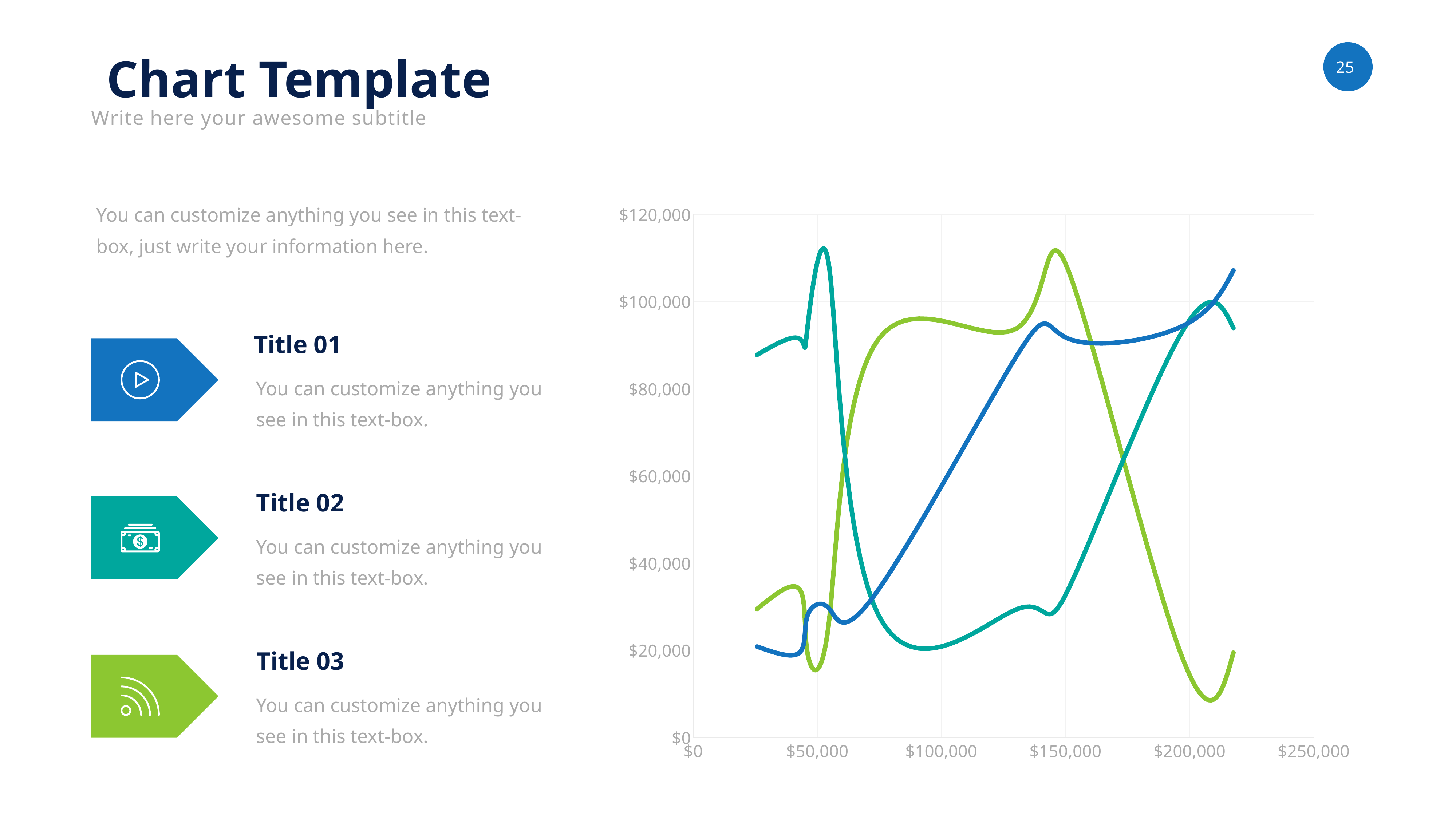
How many lines are plotted on the chart? 3 Is the value of the green line at $100,000 on the horizontal axis greater or less than $80,000? greater Does the blue line overall rise or fall from left to right across the chart? rise Is the value of the blue line at $150,000 on the horizontal axis greater or less than $80,000? greater Is the value of the green line at $200,000 on the horizontal axis greater or less than $20,000? less What is the highest value shown on the chart's vertical axis? $120,000 What kind of chart is shown on the slide? line chart What is the highest value shown on the chart's horizontal axis? $250,000 At $150,000 on the horizontal axis, which line has the higher value, the green line or the teal line? green line At $200,000 on the horizontal axis, which line has the lowest value? green line